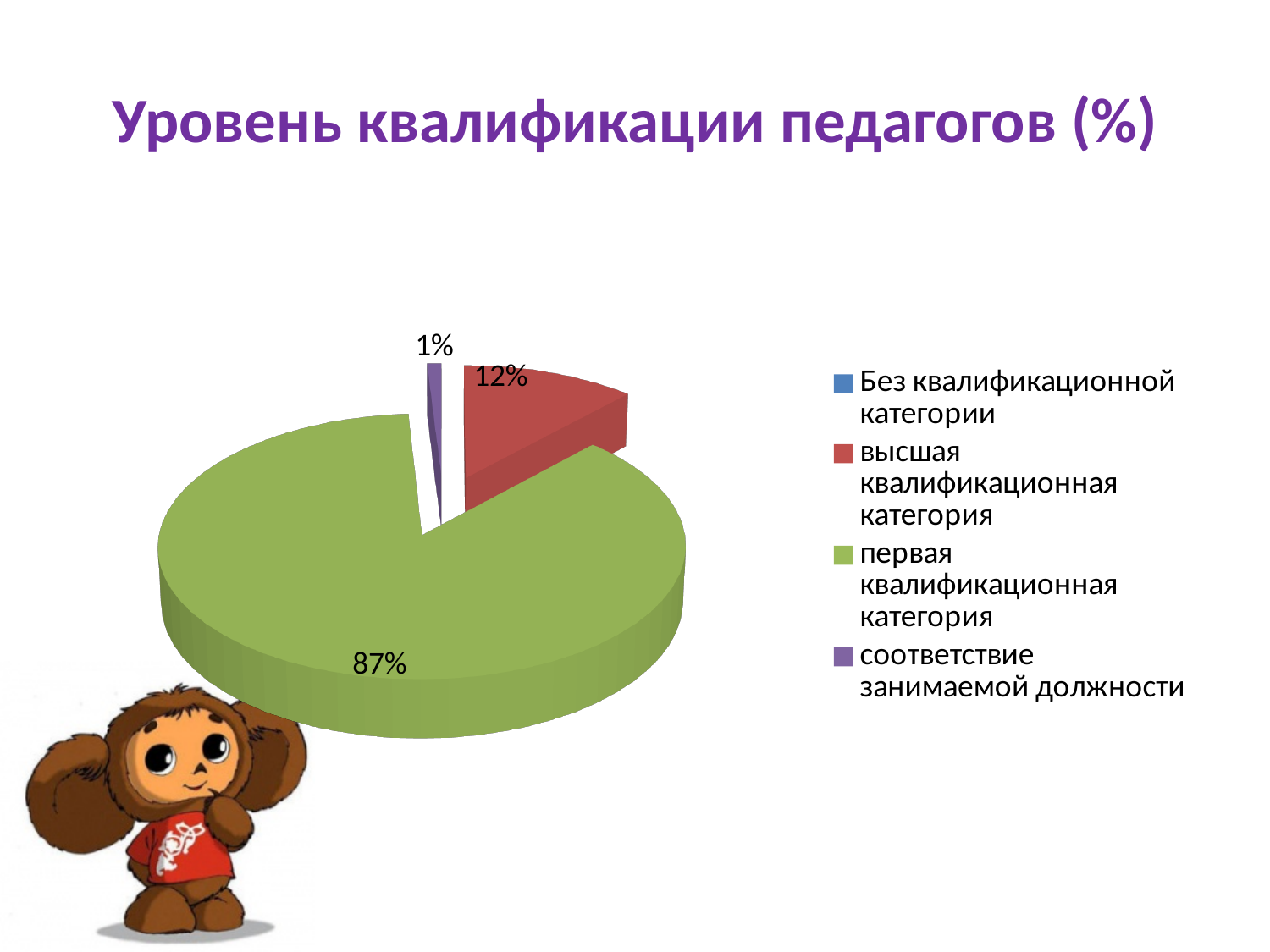
What share of the pie is labelled for 'соответствие занимаемой должности'? 1% What share of the pie is labelled for 'первая квалификационная категория'? 87% Which of the labelled slices is the smallest? соответствие занимаемой должности What is the difference in percentage points between the 'первая квалификационная категория' slice and the 'высшая квалификационная категория' slice? 75 How many slices with data labels are visible in the pie? 3 What is the title of the chart? Уровень квалификации педагогов (%) Which is larger: the slice for 'высшая квалификационная категория' or the slice for 'соответствие занимаемой должности'? высшая квалификационная категория What kind of chart is shown on the slide? pie chart How many entries does the legend list? 4 What share of the pie is labelled for 'высшая квалификационная категория'? 12% What colour is the slice for 'высшая квалификационная категория'? red Which category has the largest slice of the pie? первая квалификационная категория